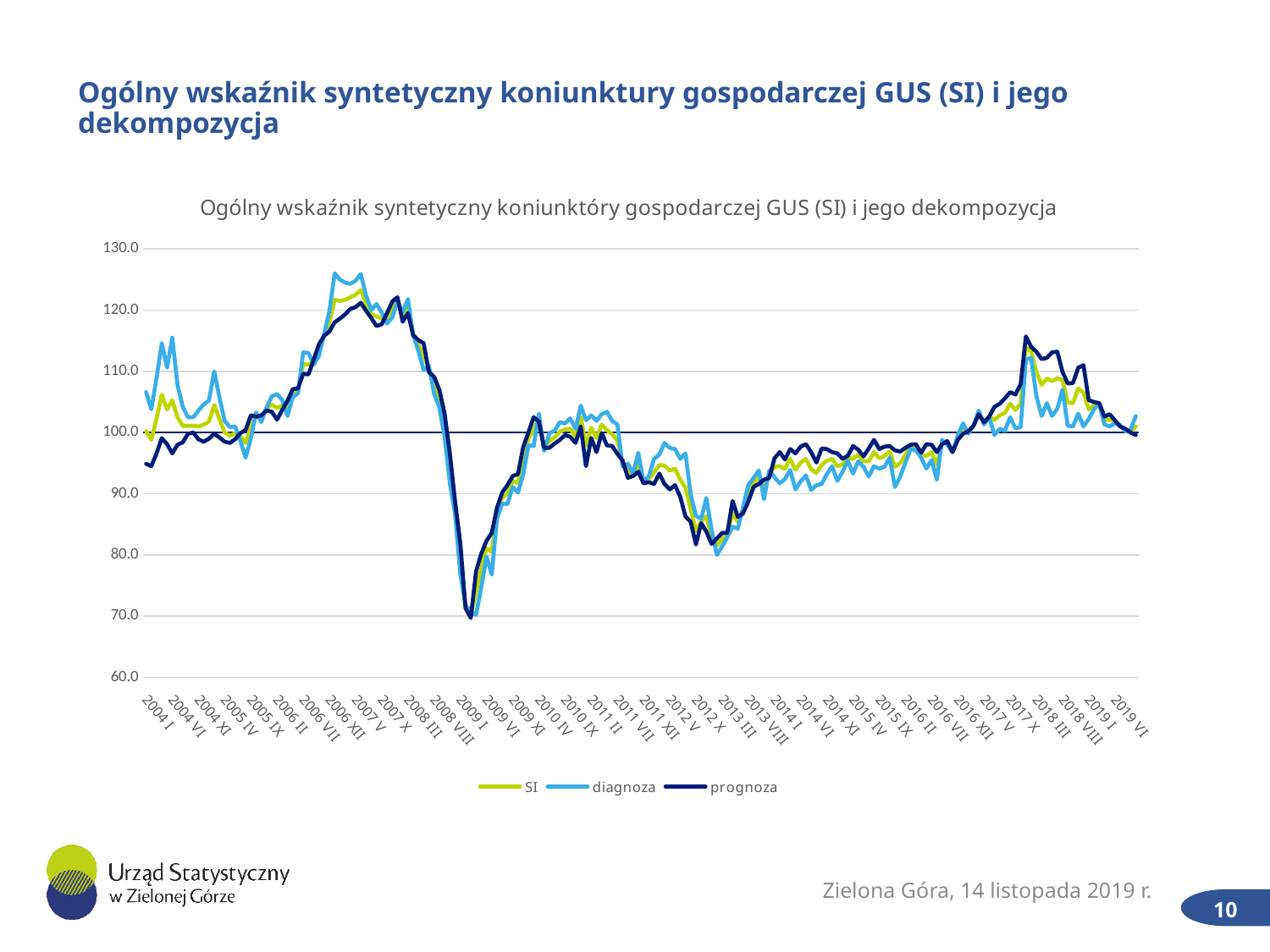
What is the title of the chart? Ogólny wskaźnik syntetyczny koniunktóry gospodarczej GUS (SI) i jego dekompozycja What is the highest value shown on the vertical axis? 130.0 Do the values of the series rise or fall between 2009 I and 2010 IV? rise What kind of chart is shown on the slide? line chart Do the values of the series rise or fall between 2007 X and 2009 I? fall Is the value of diagnoza at 2007 V greater or less than 110? greater How many series does the chart legend list? 3 Is the value of SI at 2012 X greater or less than 90? less Which series reaches the highest peak on the chart around 2007? diagnoza Is the value of prognoza at 2017 X greater or less than 110? less What are the names of the series listed in the chart legend? SI, diagnoza, prognoza